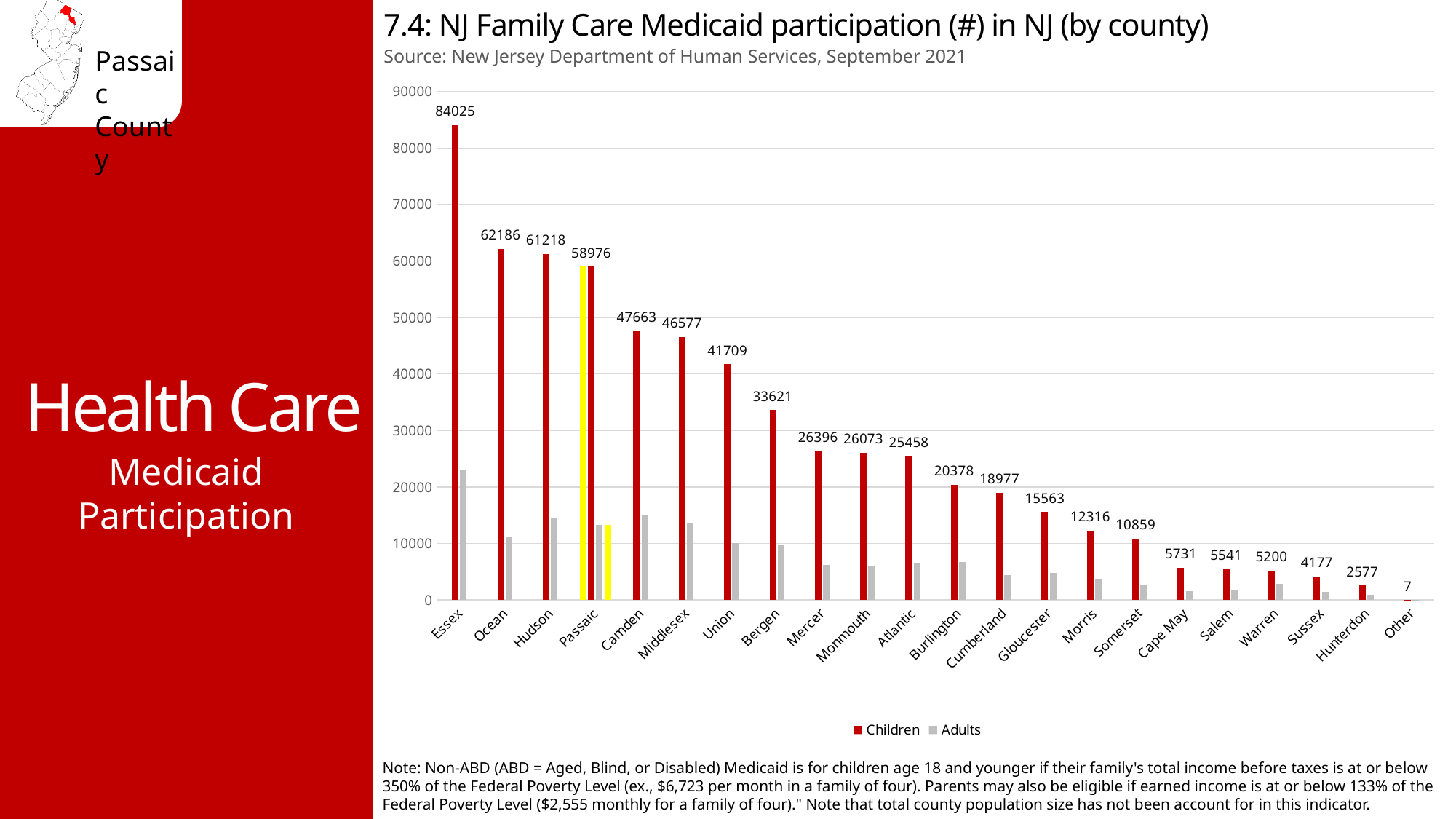
Which category has the lowest Children value? Other What kind of chart is shown on the slide? bar chart What is the difference between the Children values for Essex and Ocean? 21839 What is the Children value for Essex? 84025 Which has a larger Children value, Camden or Middlesex? Camden What is the Children value for Passaic? 58976 Which category has the highest Children value? Essex How many series does the legend list? 2 How many categories are shown on the x axis? 22 What is the difference between the Children values for Ocean and Hudson? 968 Is the Adults value for Hudson greater or less than 10000? greater Is the Adults value for Essex greater or less than 20000? greater